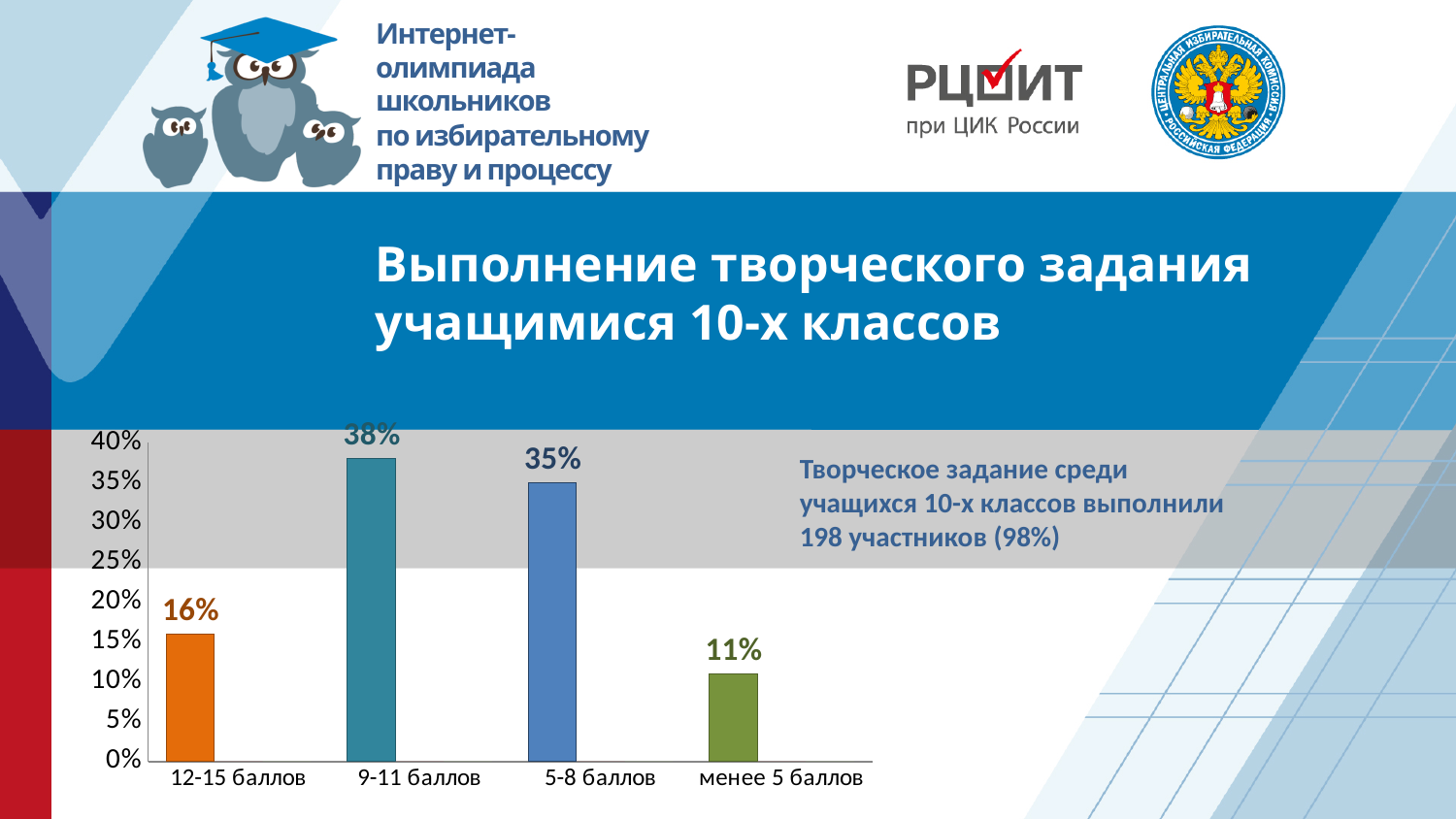
What is the difference between the values for "9-11 баллов" and "12-15 баллов"? 22% What is the value for the "9-11 баллов" category? 38% What is the value for the "12-15 баллов" category? 16% What is the title of the slide above the chart? Выполнение творческого задания учащимися 10-х классов Which category has the highest value? 9-11 баллов Which is larger, the value for "5-8 баллов" or the value for "менее 5 баллов"? 5-8 баллов Which category has the lowest value? менее 5 баллов How many categories are shown on the x axis? 4 Is the value for "12-15 баллов" greater or less than 20%? less What is the value for the "5-8 баллов" category? 35% What kind of chart is shown on the slide? bar chart What is the value for the "менее 5 баллов" category? 11%